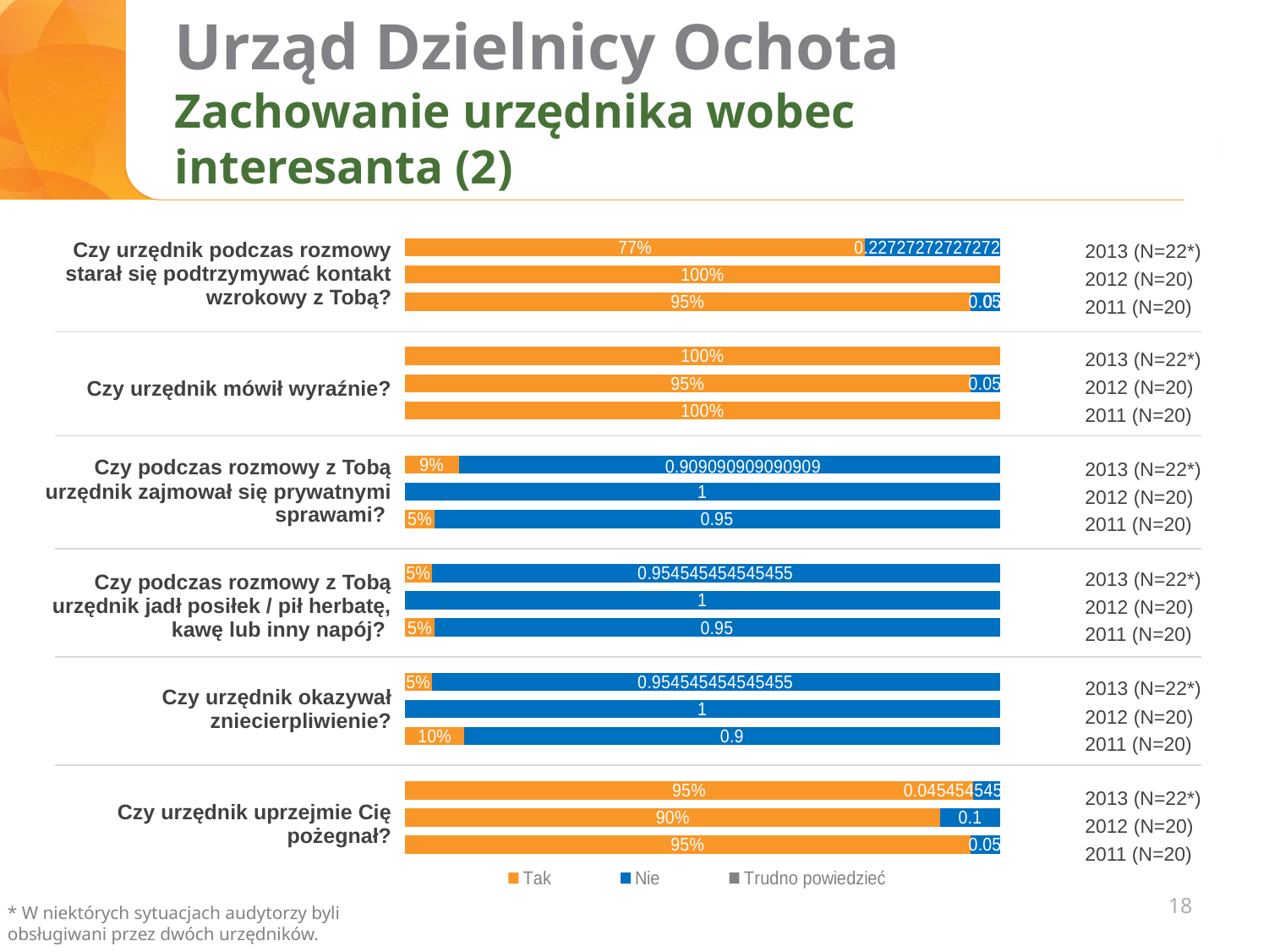
What is the 'Tak' value for 2013 (N=22*) for the question 'Czy urzędnik podczas rozmowy starał się podtrzymywać kontakt wzrokowy z Tobą?'? 77% For the question 'Czy urzędnik uprzejmie Cię pożegnał?', what is the difference in percentage points between the 'Tak' values for 2013 (N=22*) and 2012 (N=20)? 5 What is the 'Nie' value for 2013 (N=22*) for the question 'Czy urzędnik podczas rozmowy starał się podtrzymywać kontakt wzrokowy z Tobą?'? 0.22727272727272 For the question 'Czy urzędnik okazywał zniecierpliwienie?', which year has the larger 'Tak' value: 2013 (N=22*) or 2011 (N=20)? 2011 (N=20) What is the 'Nie' value for 2012 (N=20) for the question 'Czy urzędnik uprzejmie Cię pożegnał?'? 0.1 What is the 'Tak' value for 2012 (N=20) for the question 'Czy urzędnik mówił wyraźnie?'? 95% What are the legend entries of the chart? Tak, Nie, Trudno powiedzieć What is the 'Nie' value for 2011 (N=20) for the question 'Czy urzędnik okazywał zniecierpliwienie?'? 0.9 What kind of chart is shown on the slide? Stacked bar chart What is the 'Tak' value for 2013 (N=22*) for the question 'Czy podczas rozmowy z Tobą urzędnik zajmował się prywatnymi sprawami?'? 9% How many question groups are shown in the chart? 6 How many series does the legend list? 3